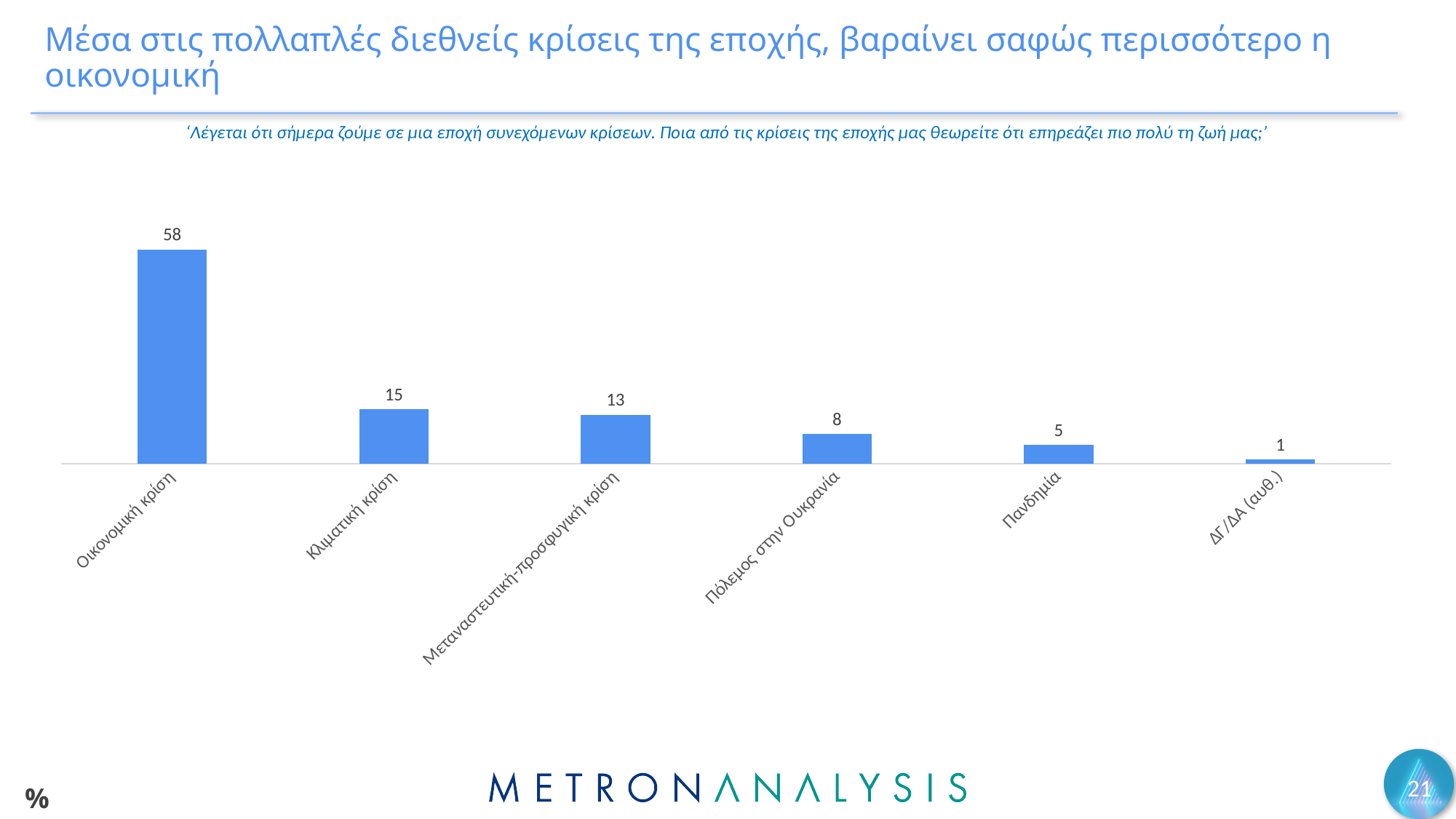
What is the value for Κλιματική κρίση? 15 What is the value for Πανδημία? 5 What kind of chart is shown on the slide? Bar chart Which category has the lowest value? ΔΓ/ΔΑ (αυθ.) Which is larger, the value for Πόλεμος στην Ουκρανία or the value for Πανδημία? Πόλεμος στην Ουκρανία How many categories are shown in the chart? 6 What is the value for Πόλεμος στην Ουκρανία? 8 What is the value for Μεταναστευτική-προσφυγική κρίση? 13 Which category has the highest value? Οικονομική κρίση Do the values rise or fall from left to right along the x axis? Fall What is the value for Οικονομική κρίση? 58 What is the difference between the values for Οικονομική κρίση and Κλιματική κρίση? 43